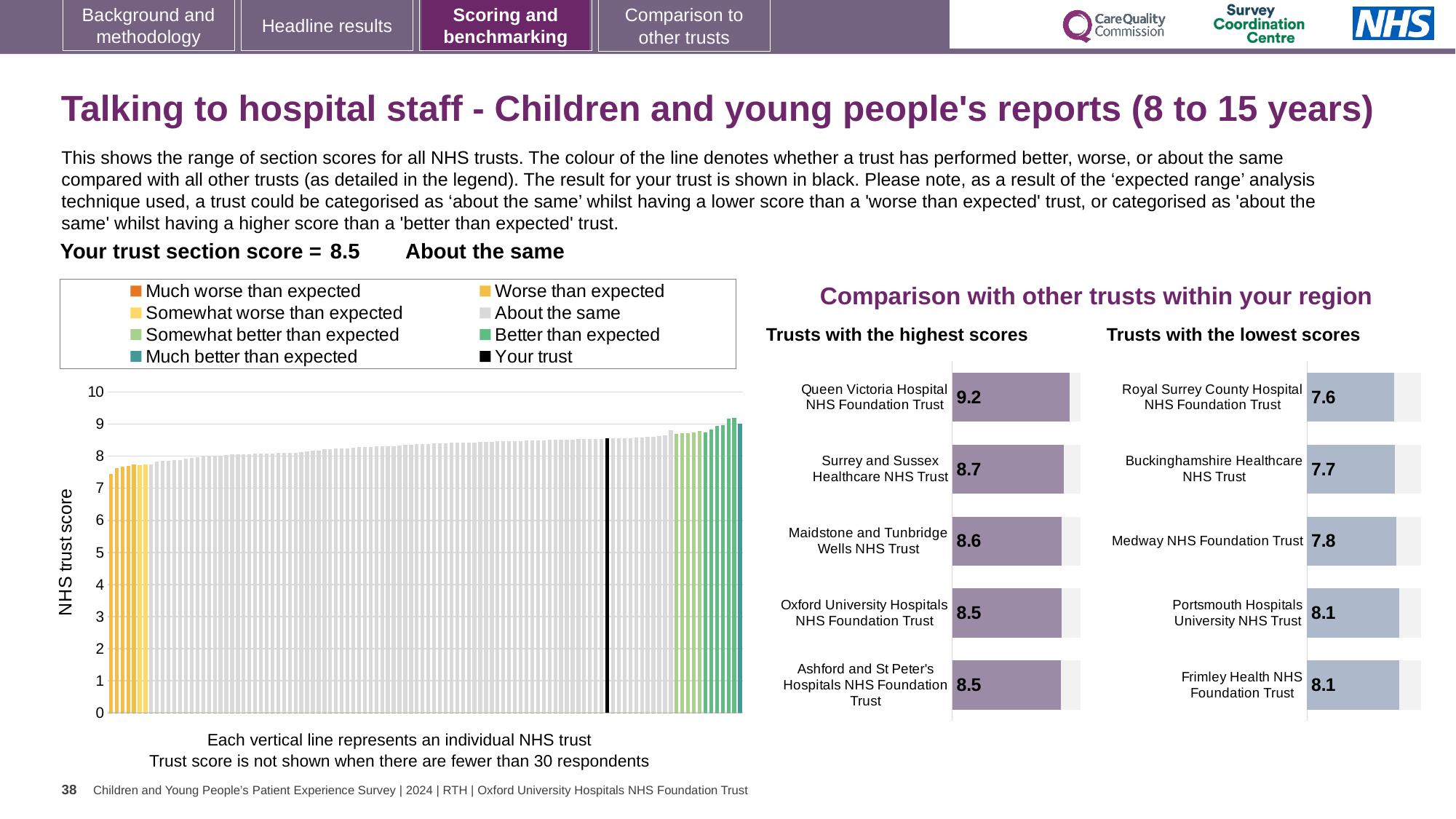
In the 'Trusts with the lowest scores' chart, what is the score for Medway NHS Foundation Trust? 7.8 In the 'Trusts with the highest scores' chart, which trust has the highest score? Queen Victoria Hospital NHS Foundation Trust In the 'Trusts with the lowest scores' chart, what is the difference between the scores of Portsmouth Hospitals University NHS Trust and Royal Surrey County Hospital NHS Foundation Trust? 0.5 In the 'Trusts with the highest scores' chart, what is the difference between the scores of Queen Victoria Hospital NHS Foundation Trust and Oxford University Hospitals NHS Foundation Trust? 0.7 In the main chart on the left, is the value of the lowest (orange) bar greater or less than 7? greater In the 'Trusts with the highest scores' chart, what is the score for Maidstone and Tunbridge Wells NHS Trust? 8.6 What kind of chart is the main chart on the left showing NHS trust scores? Bar chart How many entries does the legend of the main NHS trust score chart on the left list? 8 In the 'Trusts with the lowest scores' chart, which has the higher score: Buckinghamshire Healthcare NHS Trust or Frimley Health NHS Foundation Trust? Frimley Health NHS Foundation Trust In the 'Trusts with the lowest scores' chart, which trust has the lowest score? Royal Surrey County Hospital NHS Foundation Trust How many trusts are shown in the 'Trusts with the lowest scores' chart? 5 In the 'Trusts with the highest scores' chart, what is the score for Queen Victoria Hospital NHS Foundation Trust? 9.2